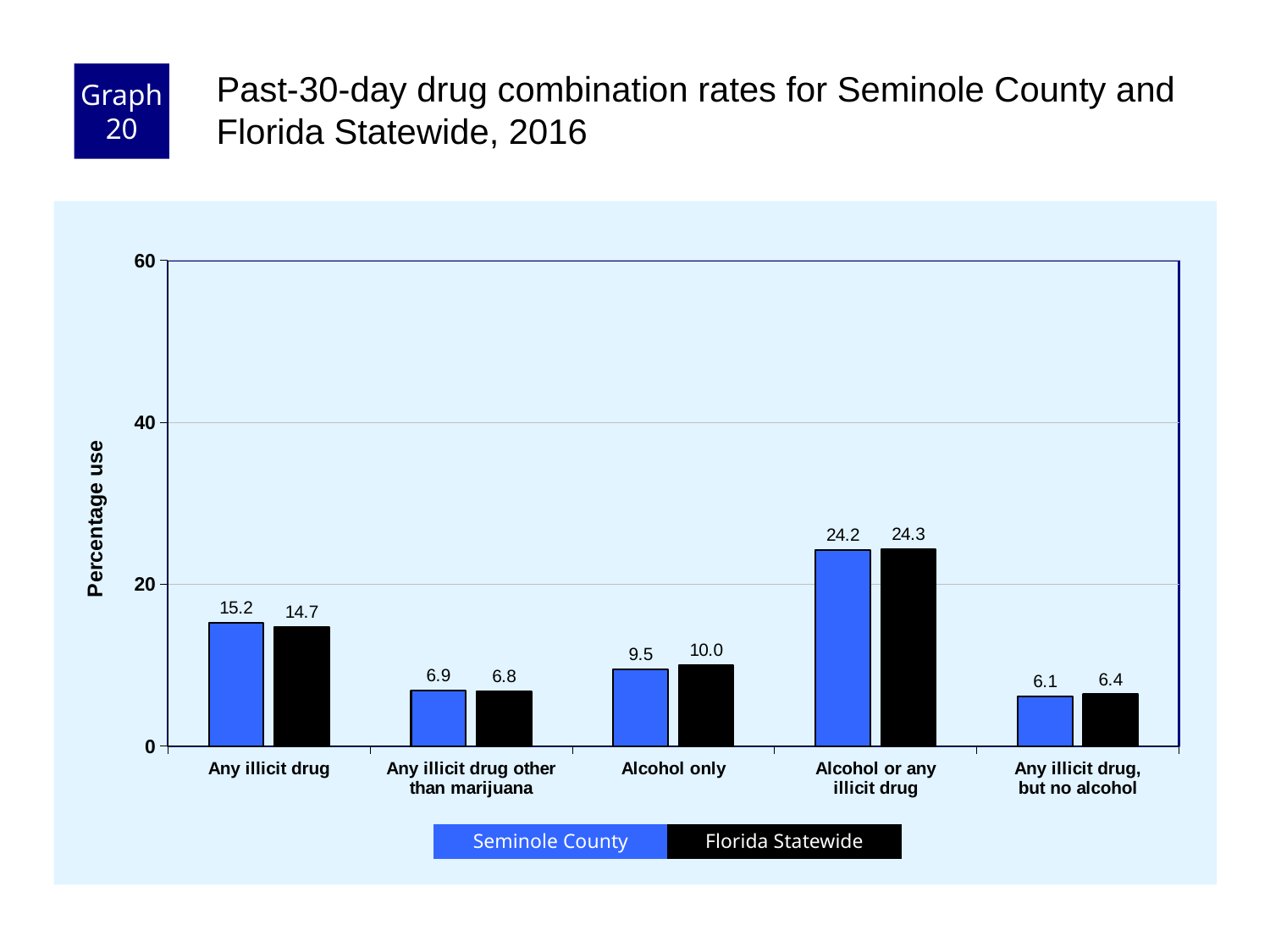
What is the label of the y axis? Percentage use How many categories are shown on the x axis? 5 Which category has the highest Seminole County value? Alcohol or any illicit drug Is the Seminole County value for Alcohol or any illicit drug greater or less than 20? greater What is the Florida Statewide value for Alcohol only? 10.0 What kind of chart is shown on the slide? bar chart Which is larger for Alcohol only: the Seminole County value or the Florida Statewide value? Florida Statewide Which category has the lowest Florida Statewide value? Any illicit drug, but no alcohol What is the Seminole County value for Any illicit drug? 15.2 What is the Florida Statewide value for Any illicit drug, but no alcohol? 6.4 What is the difference between the Seminole County and Florida Statewide values for Any illicit drug? 0.5 How many series does the legend list? 2